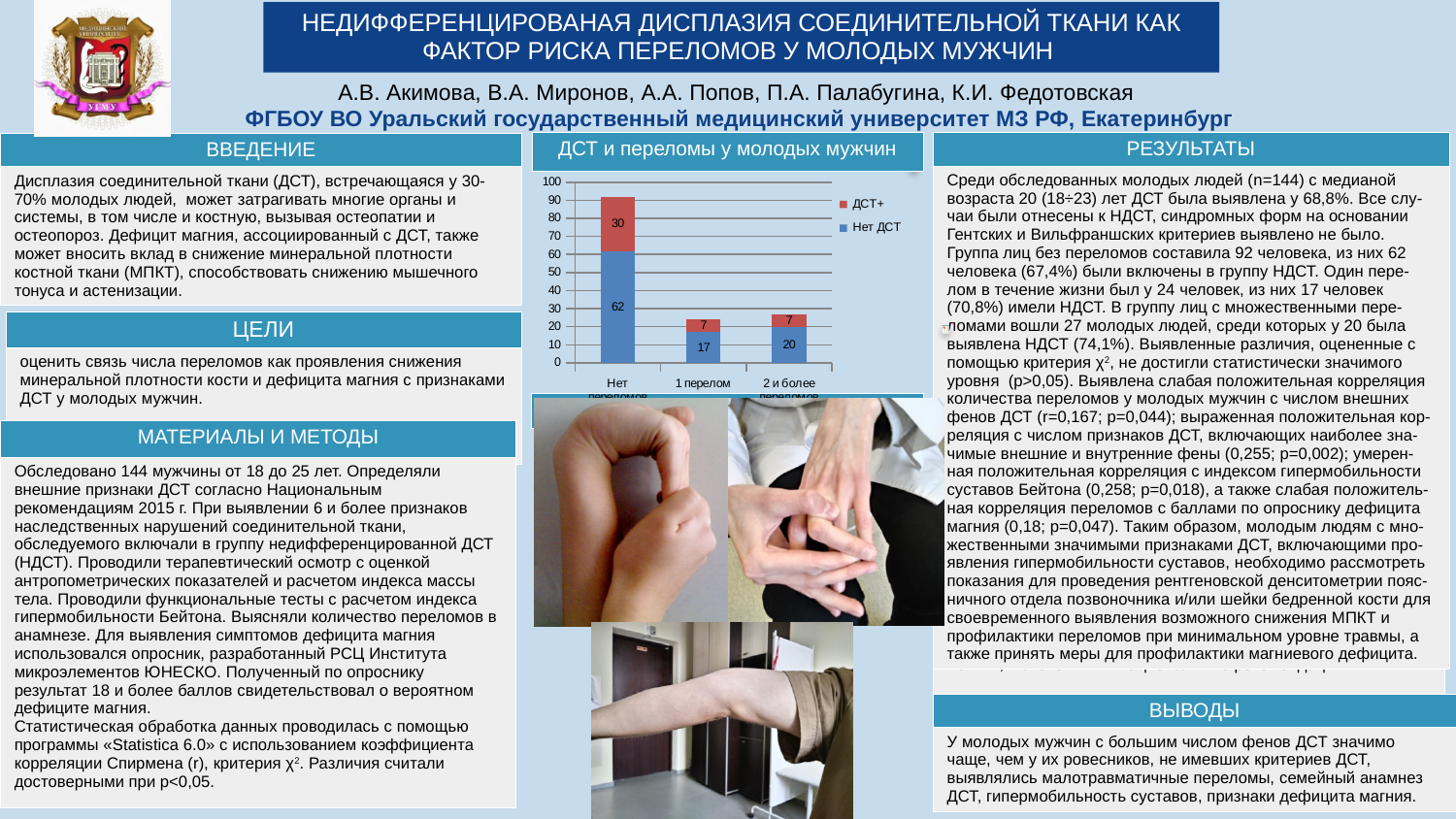
Which category has the highest total bar? Нет переломов What kind of chart is shown on the slide? stacked bar chart What is the total of the stacked bar for the 'Нет переломов' category? 92 What is the difference between the 'Нет ДСТ' values for '2 и более переломов' and '1 перелом'? 3 What is the value of the 'Нет ДСТ' series for the 'Нет переломов' category? 62 How many categories are shown on the x axis of the chart? 3 What is the value of the 'ДСТ+' series for the '2 и более переломов' category? 7 What is the total of the stacked bar for the '2 и более переломов' category? 27 What is the value of the 'Нет ДСТ' series for the '1 перелом' category? 17 How many series does the chart legend list? 2 What is the value of the 'ДСТ+' series for the 'Нет переломов' category? 30 Which series is shown in red in the chart legend? ДСТ+